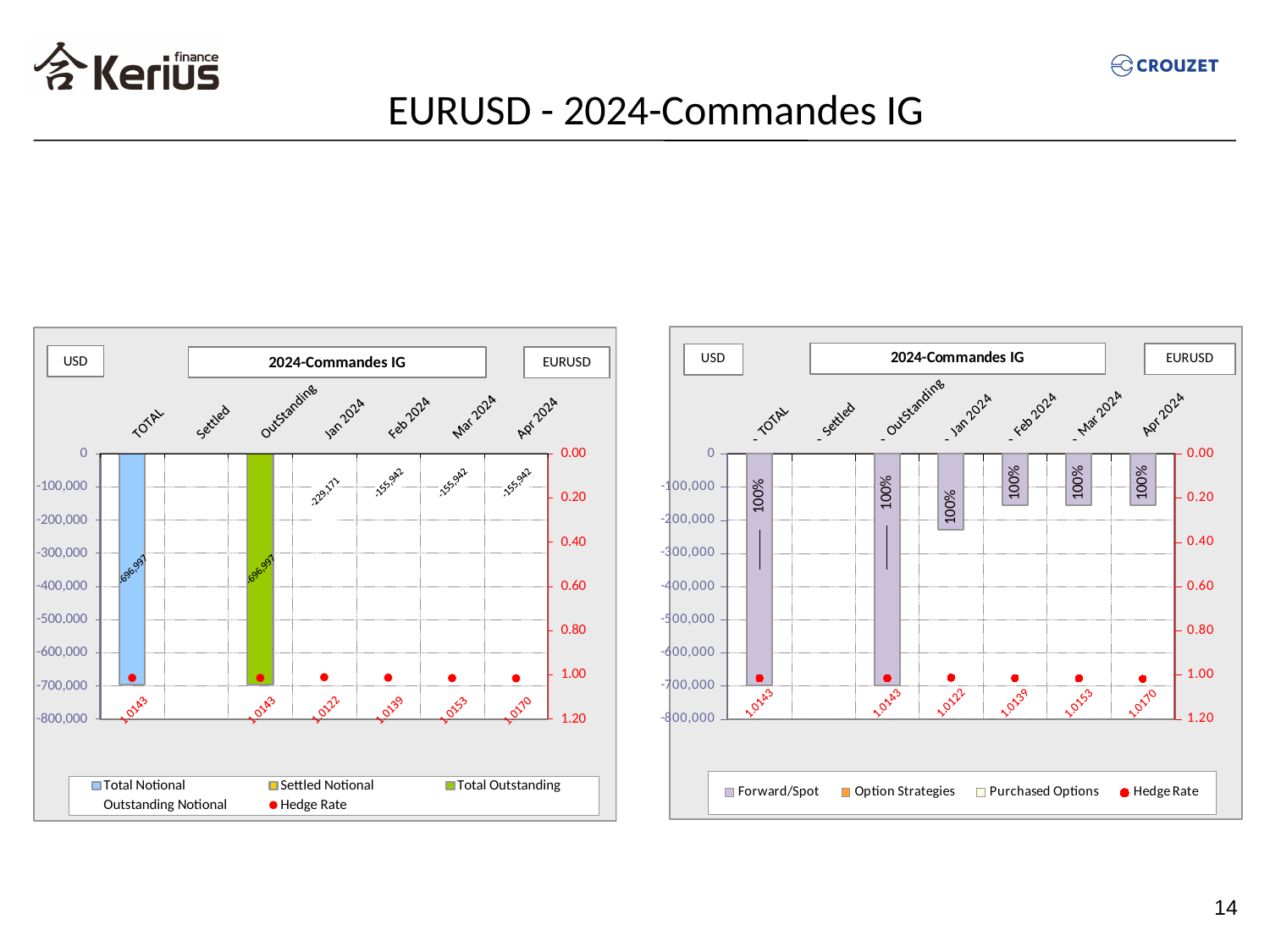
In the right chart, what percentage label is shown on the Forward/Spot bar for Mar 2024? 100% In the right chart, what is the Hedge Rate value shown for Outstanding? 1.0143 In the left chart, what is the data label on the TOTAL bar? -696,997 In the left chart, which month from Jan 2024 to Apr 2024 has the lowest Hedge Rate value? Jan 2024 What kind of chart is the left chart? Bar chart with a line/marker series In the left chart, which month from Jan 2024 to Apr 2024 has the highest Hedge Rate value? Apr 2024 In the left chart, what value is printed for Feb 2024? -155,942 In the left chart, what is the difference between the printed values for Jan 2024 (-229,171) and Feb 2024 (-155,942)? 73,229 How many series does the legend of the right chart list? 4 How many categories are shown along the x axis of the left chart? 7 In the left chart, what value is printed for Jan 2024? -229,171 In the left chart, what is the Hedge Rate value shown for Apr 2024? 1.0170